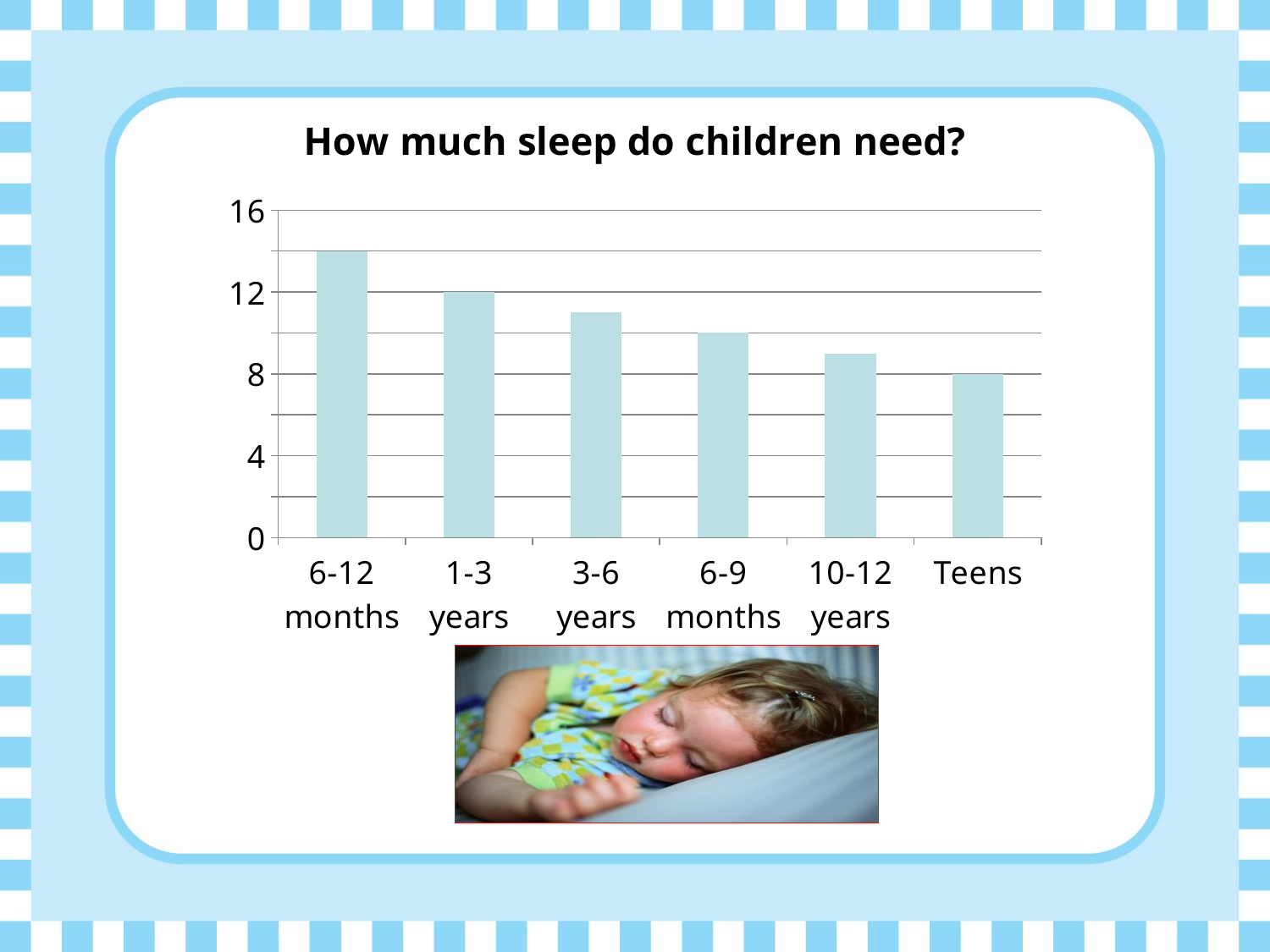
What is the value for 1-3 years? 12 Which is larger, the value for 6-12 months or the value for 3-6 years? 6-12 months What is the difference between the values for 1-3 years and Teens? 4 What is the title of the chart? How much sleep do children need? Which category has the highest value? 6-12 months Is the value for 6-12 months greater or less than 12? greater Which category has the lowest value? Teens Do the values rise or fall moving from left to right along the x axis? fall How many age categories are shown on the x axis? 6 What is the value for Teens? 8 What type of chart is shown on the slide? bar chart Is the value for 10-12 years greater or less than 8? greater